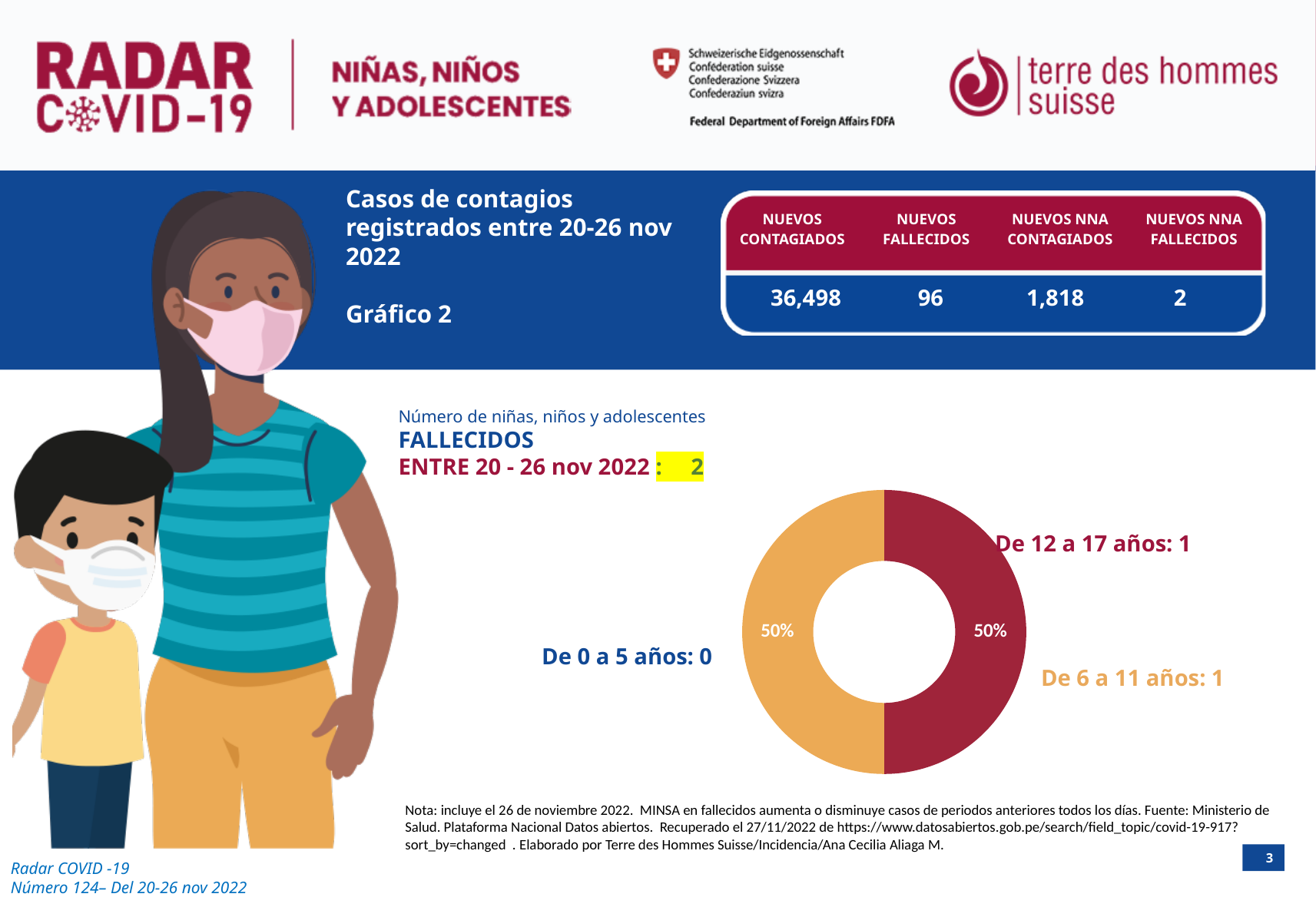
Which age group has the lowest number of deaths in the chart? De 0 a 5 años What share of the donut chart does the 'De 6 a 11 años' slice represent? 50% What colour is the 'De 12 a 17 años' slice of the donut chart? Dark red What kind of chart is shown on the slide? Donut (pie) chart How many deaths are shown for the 'De 0 a 5 años' group? 0 What is the total number of deaths across all age groups shown in the chart? 2 What share of the donut chart does the 'De 12 a 17 años' slice represent? 50% How many deaths are shown for the 'De 12 a 17 años' group? 1 What is the difference between the deaths for 'De 6 a 11 años' and 'De 0 a 5 años'? 1 How many deaths are shown for the 'De 6 a 11 años' group? 1 How many age groups are labelled on the chart? 3 What period does the chart of deaths among children and adolescents cover? 20 - 26 nov 2022